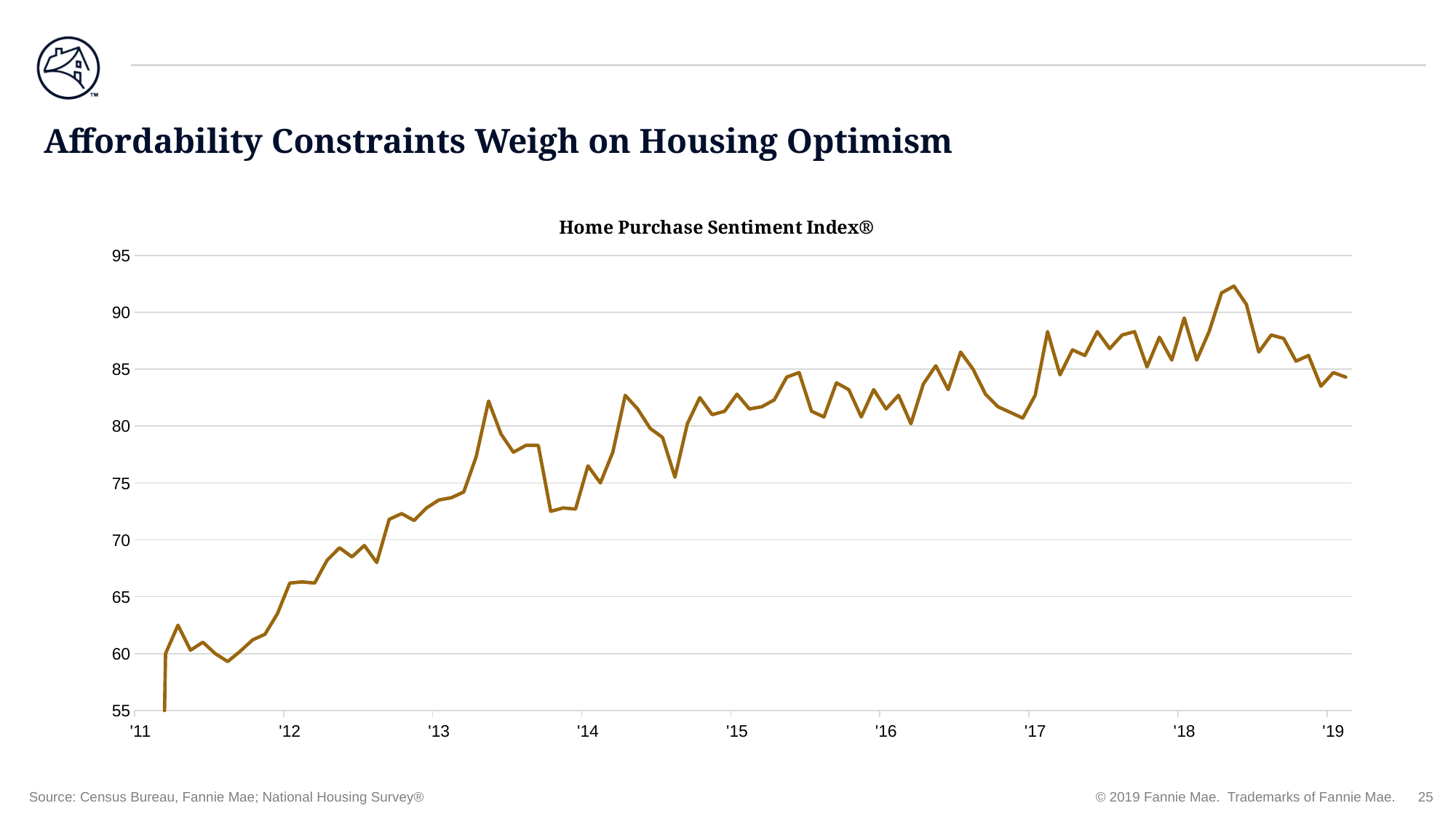
What kind of chart is shown on the slide? line chart What is the lowest value shown on the vertical axis? 55 Is the value of the index at the '12 tick greater or less than 70? less What is the title of the chart? Home Purchase Sentiment Index® Is the highest point of the line, reached in 2018, greater or less than 90? greater Is the value of the index at the '13 tick greater or less than 70? greater How many lines (series) are plotted on the chart? 1 In which year does the line reach its highest value? 2018 Overall, does the Home Purchase Sentiment Index rise or fall from '11 to '19? rise